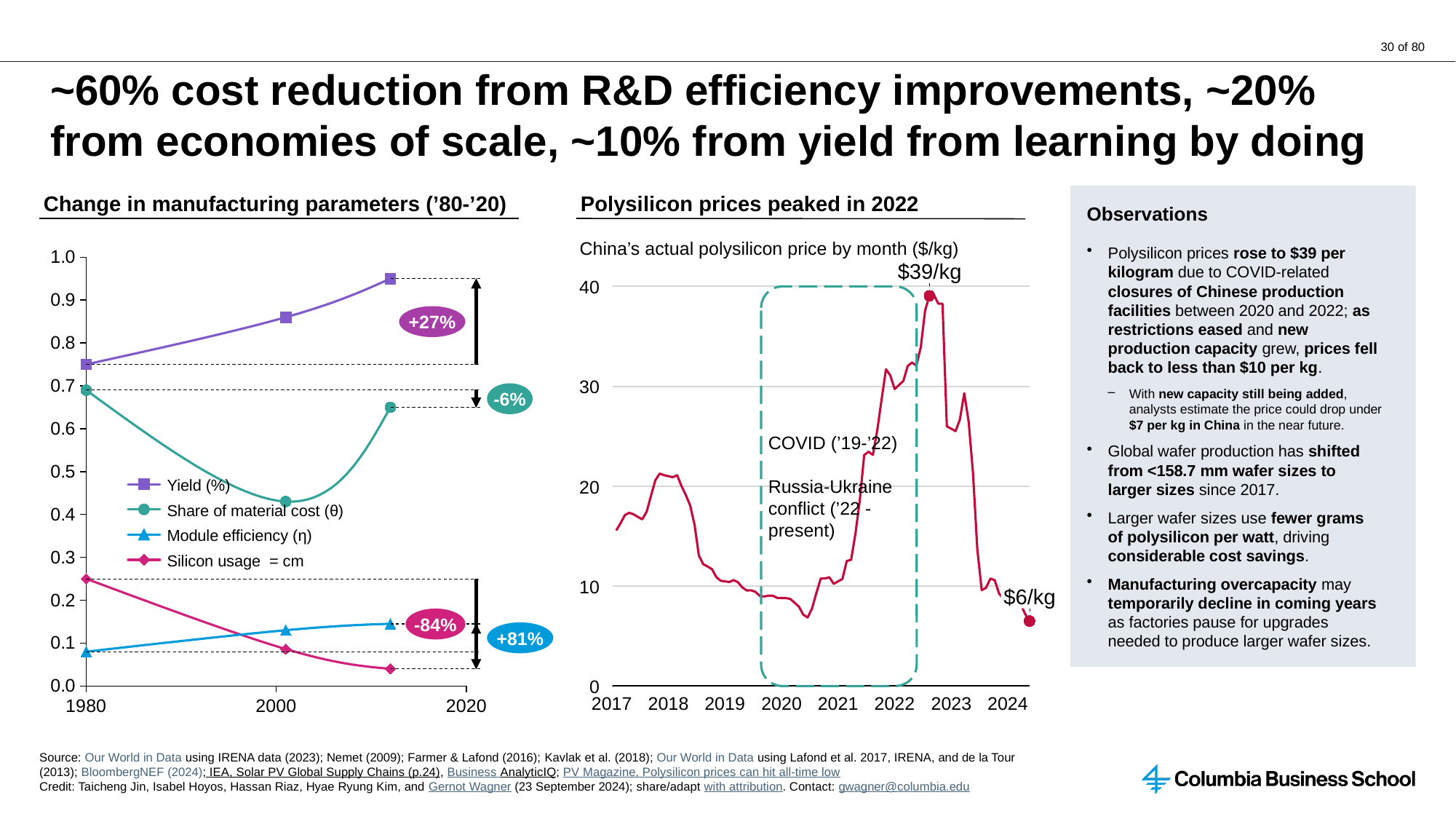
In the 'Change in manufacturing parameters ('80-'20)' chart, is the value for Share of material cost (θ) in 2000 greater or less than 0.5? less In the 'Polysilicon prices peaked in 2022' chart, what is the labelled price at the end of the series in 2024? $6/kg In the 'Change in manufacturing parameters ('80-'20)' chart, what percentage change is annotated for Share of material cost (θ)? -6% In the 'Change in manufacturing parameters ('80-'20)' chart, what percentage change is annotated for Yield (%)? +27% In the 'Change in manufacturing parameters ('80-'20)' chart, what percentage change is annotated for Module efficiency (η)? +81% How many series does the legend of the 'Change in manufacturing parameters ('80-'20)' chart list? 4 In the 'Change in manufacturing parameters ('80-'20)' chart, is the value for Yield (%) in 1980 greater or less than 0.7? greater In the 'Polysilicon prices peaked in 2022' chart, what is the difference between the labelled peak price and the labelled 2024 price? $33/kg In the 'Change in manufacturing parameters ('80-'20)' chart, what percentage change is annotated for Silicon usage? -84% In the 'Polysilicon prices peaked in 2022' chart, what is the labelled peak price? $39/kg In the 'Change in manufacturing parameters ('80-'20)' chart, does Silicon usage rise or fall from 1980 to 2020? fall What type of chart is the 'Change in manufacturing parameters ('80-'20)' chart? line chart